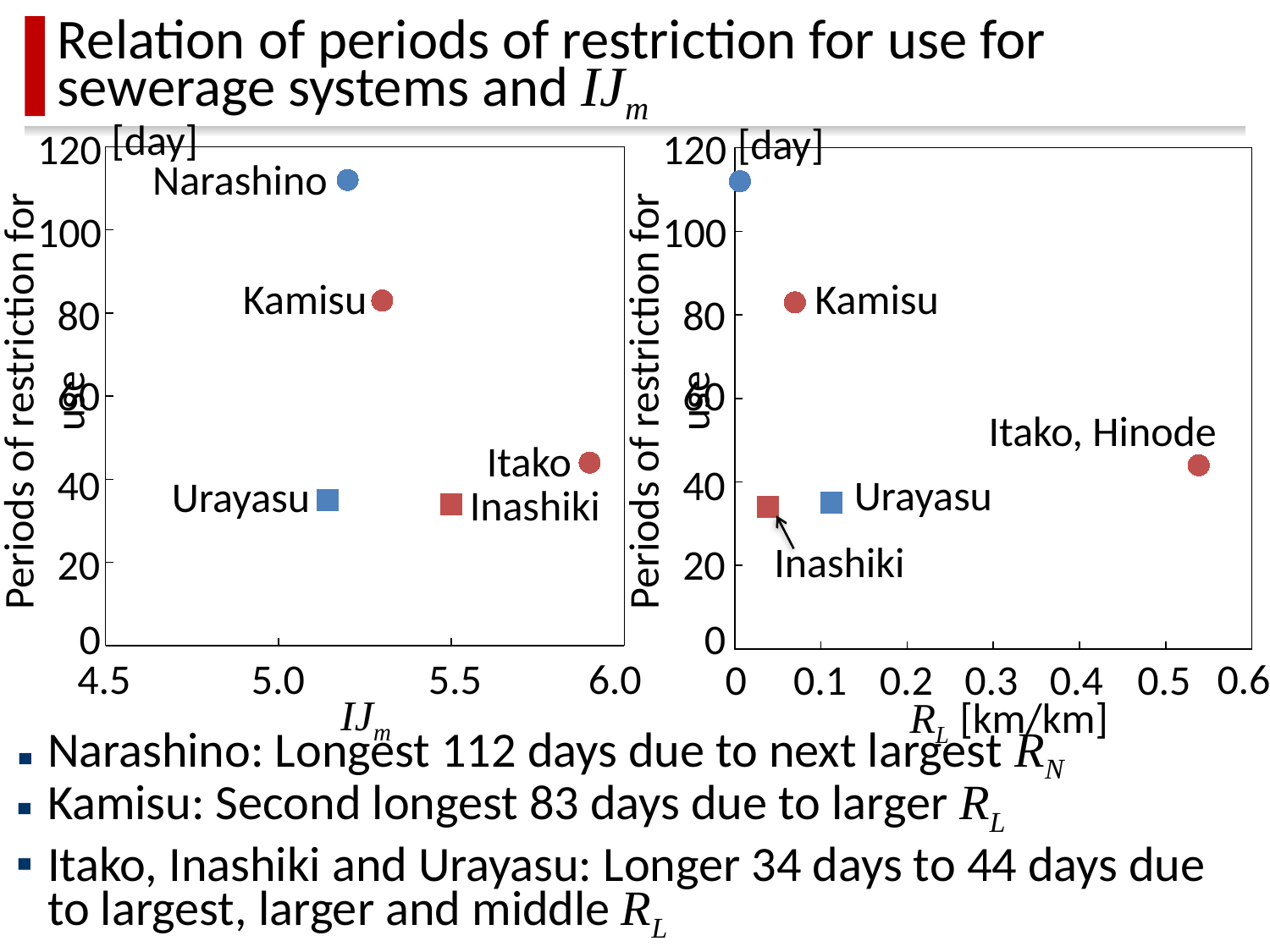
In the left chart (periods of restriction versus IJm), is the period of restriction for Narashino greater or less than 100 days? greater What is the x-axis label of the right chart? RL [km/km] What is the highest tick value shown on the y-axis of the left chart? 120 In the right chart (periods of restriction versus RL), is the RL value for Itako, Hinode greater or less than 0.5 km/km? greater In the left chart (periods of restriction versus IJm), which has a longer period of restriction, Kamisu or Urayasu? Kamisu In the left chart (periods of restriction versus IJm), is the period of restriction for Itako greater or less than 60 days? less What kind of chart is the left chart (periods of restriction versus IJm)? scatter chart In the left chart (periods of restriction versus IJm), how many locations are plotted? 5 In the left chart (periods of restriction versus IJm), which location has the longest period of restriction for use? Narashino In the right chart (periods of restriction versus RL), which has a longer period of restriction, Kamisu or Itako, Hinode? Kamisu